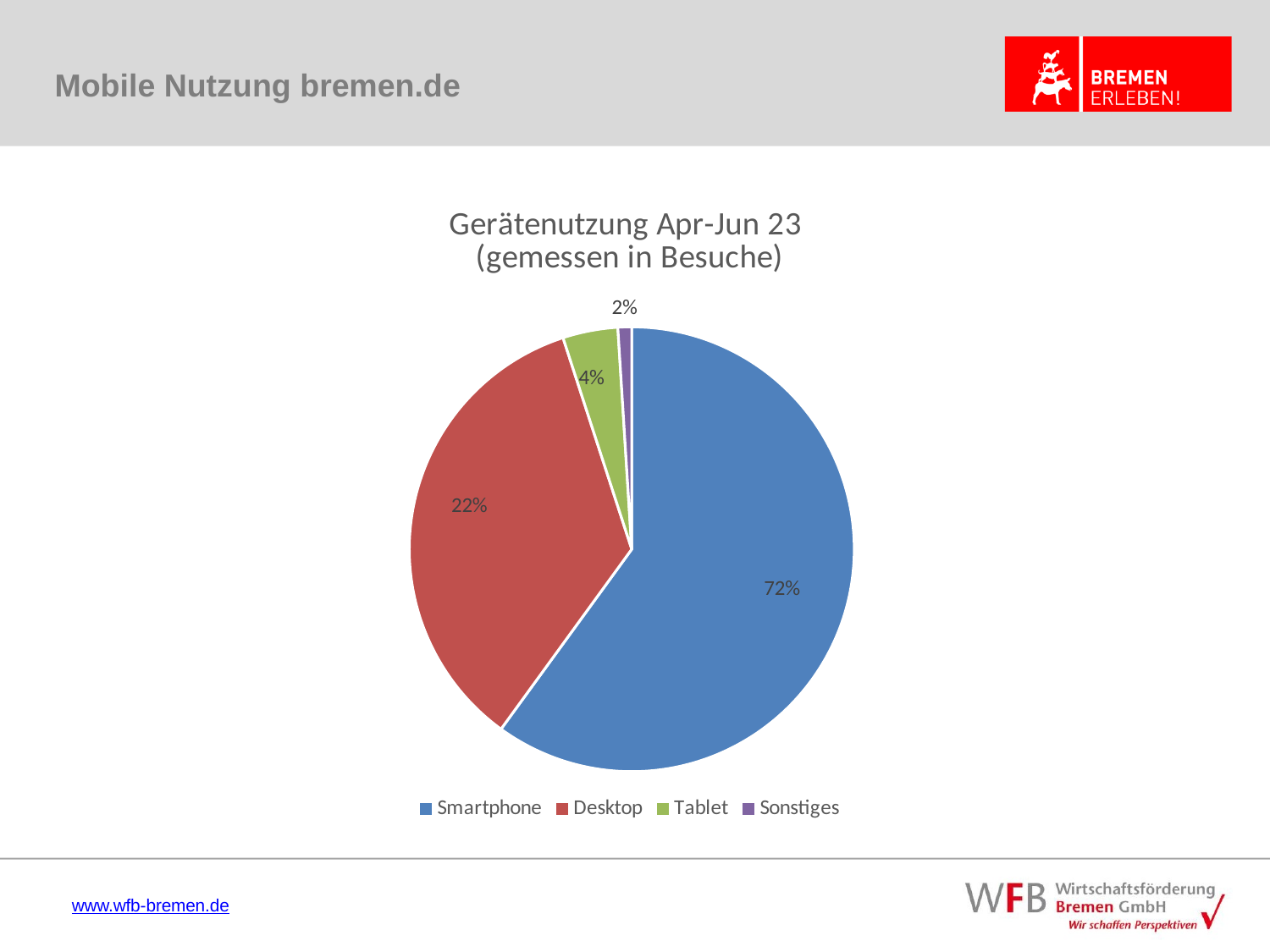
Which category has the smallest slice of the pie? Sonstiges How many categories does the pie chart show? 4 What is the difference in percentage points between the Smartphone and Desktop shares? 50 What kind of chart is shown on the slide? Pie chart What share of the pie does Desktop have? 22% What share of the pie does Smartphone have? 72% Which is larger, the Desktop share or the Tablet share? Desktop What share of the pie does Sonstiges have? 2% Which colour represents Desktop in the legend? Red What is the title of the chart? Gerätenutzung Apr-Jun 23 (gemessen in Besuche) Which category has the largest slice of the pie? Smartphone